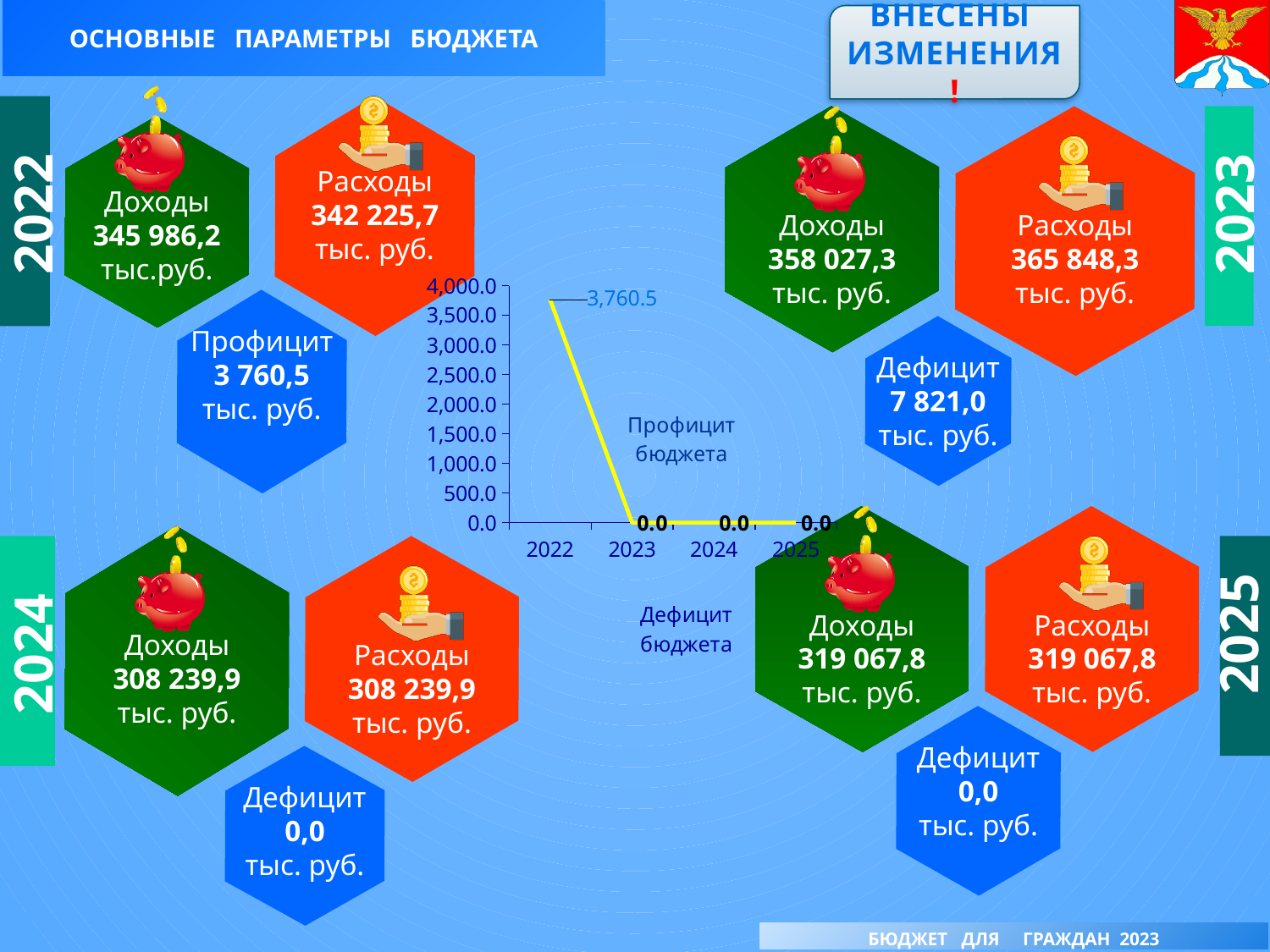
Which year has the highest value on the line chart? 2022 What is the value plotted for 2024 on the line chart? 0.0 Does the line on the chart rise or fall from 2022 to 2023? fall What colour is the line on the chart? yellow What is the value plotted for 2023 on the line chart? 0.0 What is the value plotted for 2022 on the line chart? 3,760.5 What is the maximum value shown on the y axis of the line chart? 4,000.0 What type of chart is shown in the centre of the slide? line chart What is the value plotted for 2025 on the line chart? 0.0 Is the value for 2022 on the line chart greater or less than 3,500.0? greater How many years are plotted on the x axis of the line chart? 4 What is the difference between the values for 2022 and 2023 on the line chart? 3,760.5